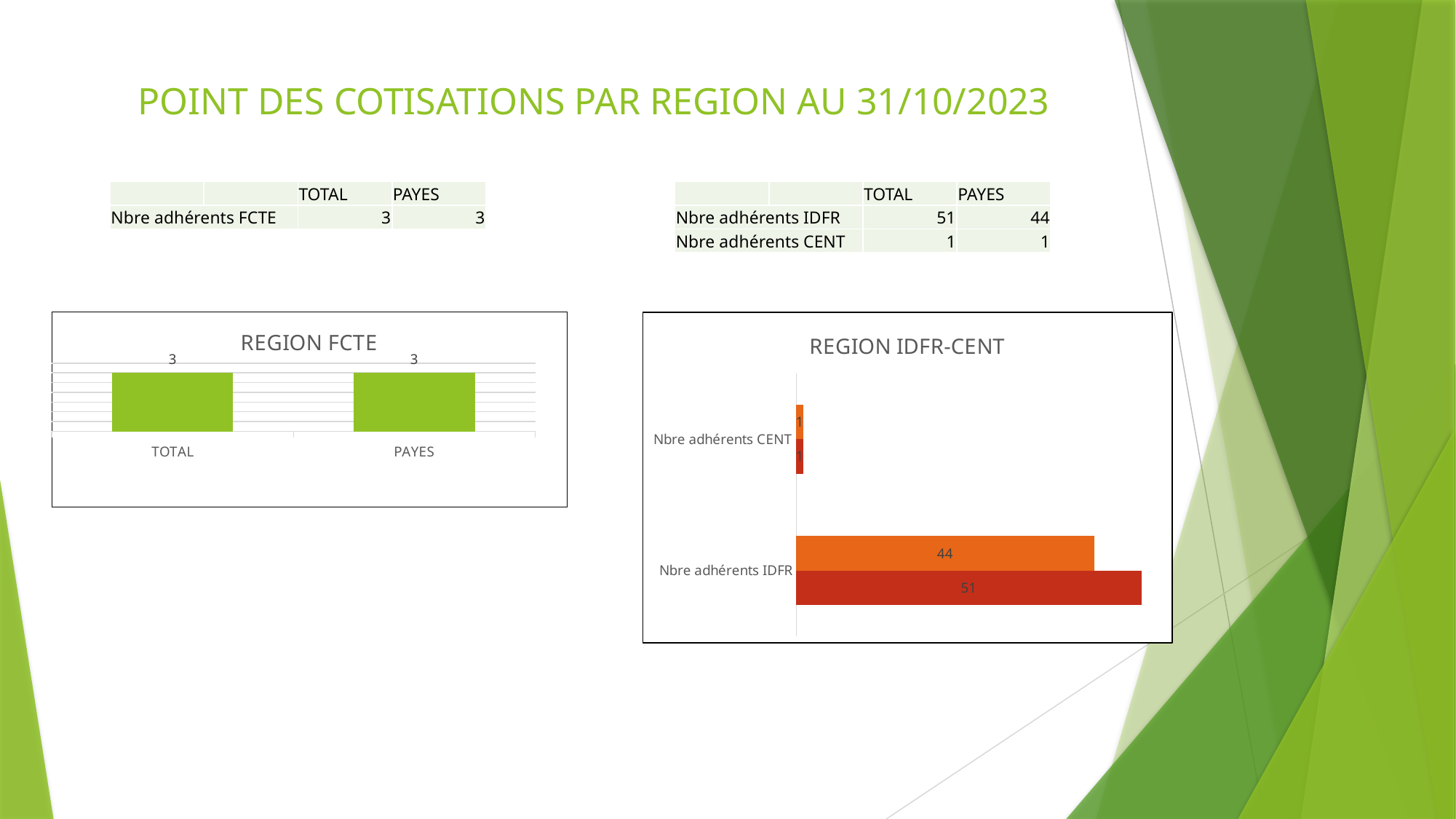
How many categories are shown on the x axis of the REGION FCTE chart? 2 In the REGION IDFR-CENT chart, what is the value of the shorter (orange) bar for Nbre adhérents IDFR? 44 What type of chart is the REGION IDFR-CENT chart? bar chart How many categories are shown in the REGION IDFR-CENT chart? 2 In the REGION IDFR-CENT chart, what is the difference between the two bars for Nbre adhérents IDFR (51 and 44)? 7 In the REGION FCTE chart, what is the value for TOTAL? 3 In the REGION FCTE chart, what is the value for PAYES? 3 What is the title of the chart on the right side of the slide? REGION IDFR-CENT In the REGION IDFR-CENT chart, which category has the highest value? Nbre adhérents IDFR In the REGION FCTE chart, what is the difference between the TOTAL and PAYES values? 0 In the REGION IDFR-CENT chart, what is the value of the longer bar for Nbre adhérents IDFR? 51 What type of chart is the REGION FCTE chart? bar chart